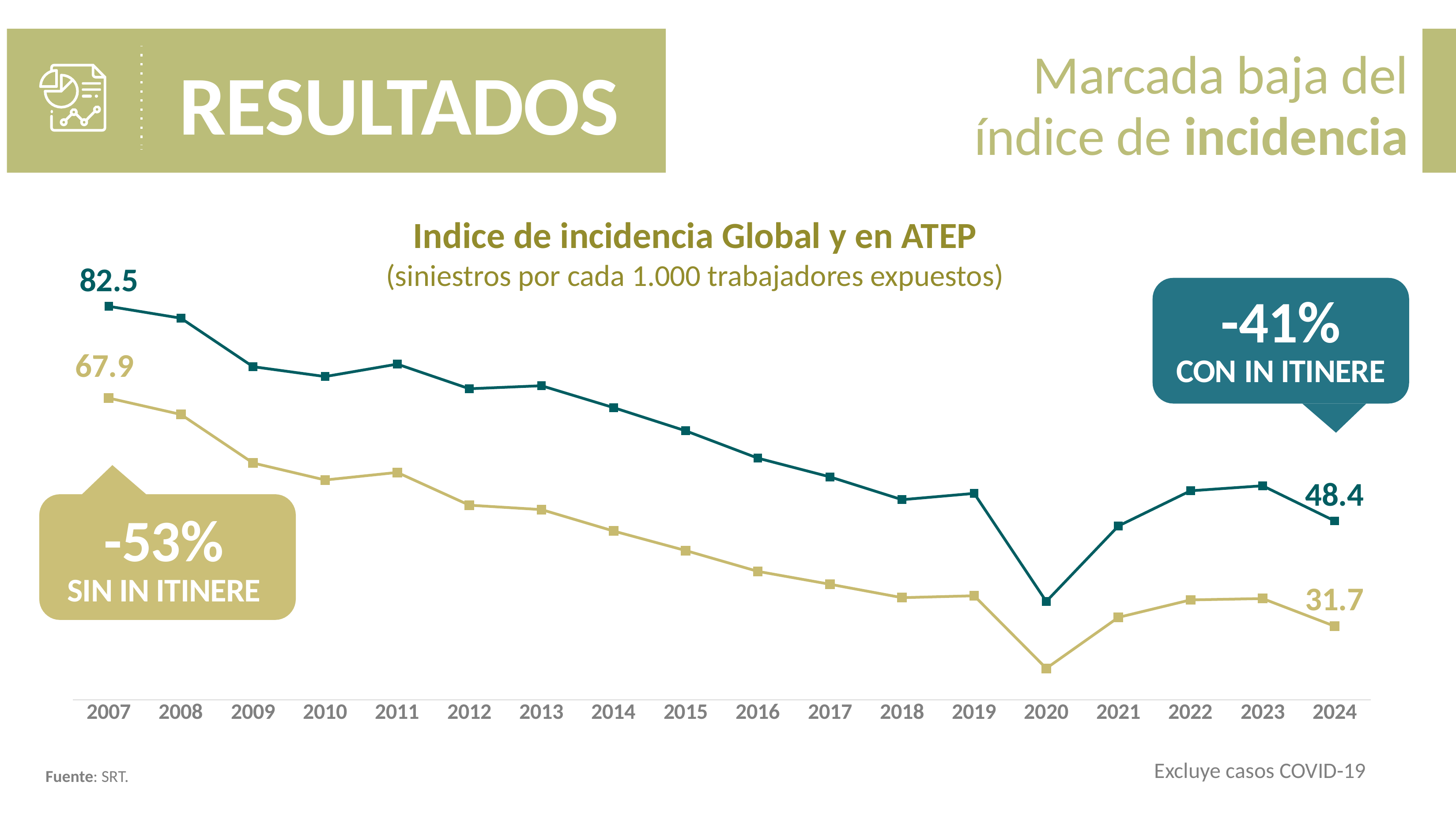
What is the title of the chart? Indice de incidencia Global y en ATEP What is the value of the gold line (sin in itinere) in 2007? 67.9 What is the value of the gold line (sin in itinere) in 2024? 31.7 In which year does the dark teal line (con in itinere) reach its lowest point? 2020 What is the value of the dark teal line (con in itinere) in 2007? 82.5 Overall, do the values rise or fall from 2007 to 2024? Fall What is the value of the dark teal line (con in itinere) in 2024? 48.4 What kind of chart is shown on the slide? Line chart What is the difference between the two lines in 2024? 16.7 How many years are shown on the x axis? 18 By how much did the dark teal line (con in itinere) fall from 2007 to 2024? 34.1 By how much did the gold line (sin in itinere) fall from 2007 to 2024? 36.2